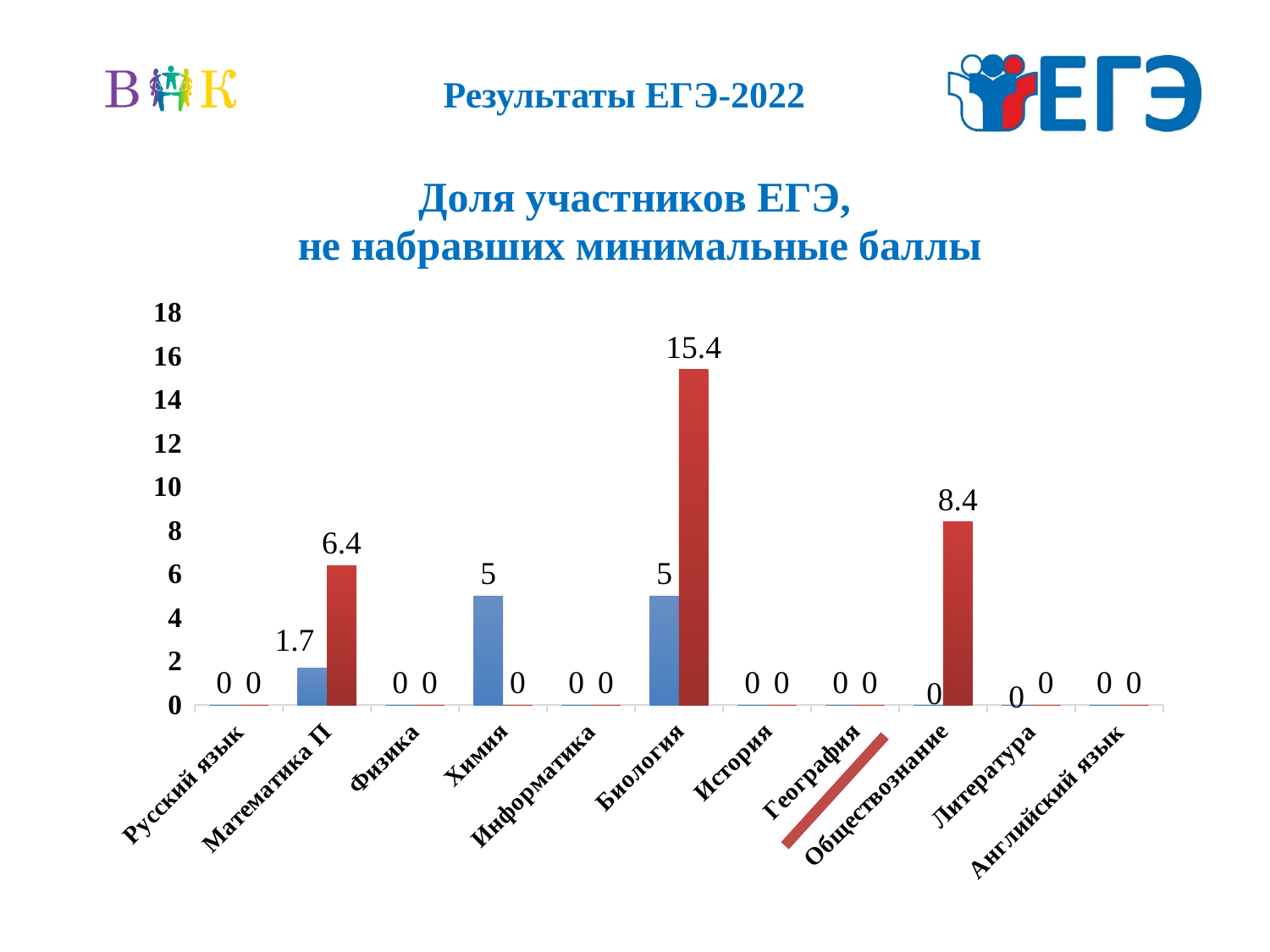
What type of chart is shown on the slide? bar chart How many subject categories are shown on the x axis? 11 What is the title of the chart? Доля участников ЕГЭ, не набравших минимальные баллы Which subject has the highest value on the chart? Биология What is the value of the blue bar for Химия? 5 Is the red bar for Биология greater or less than 14? greater What is the value of the blue bar for Математика П? 1.7 What is the value of the red bar for Биология? 15.4 What is the difference between the red bar and the blue bar for Биология? 10.4 Which is larger: the red bar for Обществознание or the red bar for Математика П? Обществознание What is the difference between the red bar and the blue bar for Математика П? 4.7 What is the value of the red bar for Обществознание? 8.4